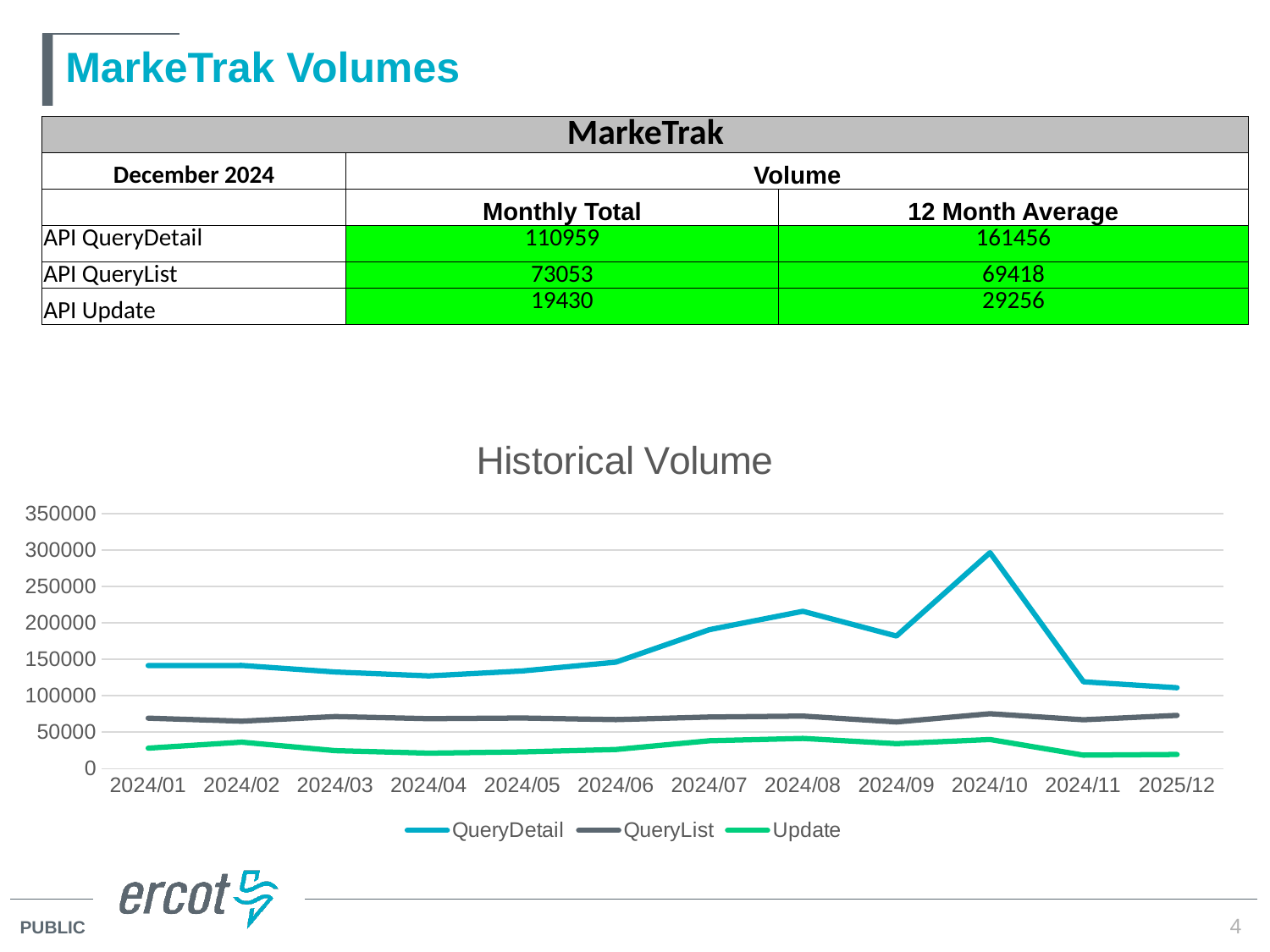
What is the title of the line chart on the slide? Historical Volume In the Historical Volume chart, does the QueryDetail series rise or fall from 2024/10 to 2024/11? fall How many months are shown on the x axis of the Historical Volume chart? 12 In the Historical Volume chart, is the QueryList value for 2024/08 greater or less than 100000? less What type of chart is the Historical Volume chart? line chart In the Historical Volume chart, is the QueryDetail value for 2024/10 greater or less than 250000? greater In the Historical Volume chart, which series has the lowest values across all months? Update How many series does the legend of the Historical Volume chart list? 3 Which series in the Historical Volume chart is drawn in green? Update In the Historical Volume chart, in which month does the QueryDetail series reach its highest value? 2024/10 In the Historical Volume chart, which series is higher in 2024/06, QueryDetail or QueryList? QueryDetail In the Historical Volume chart, is the Update value for 2024/02 greater or less than 50000? less